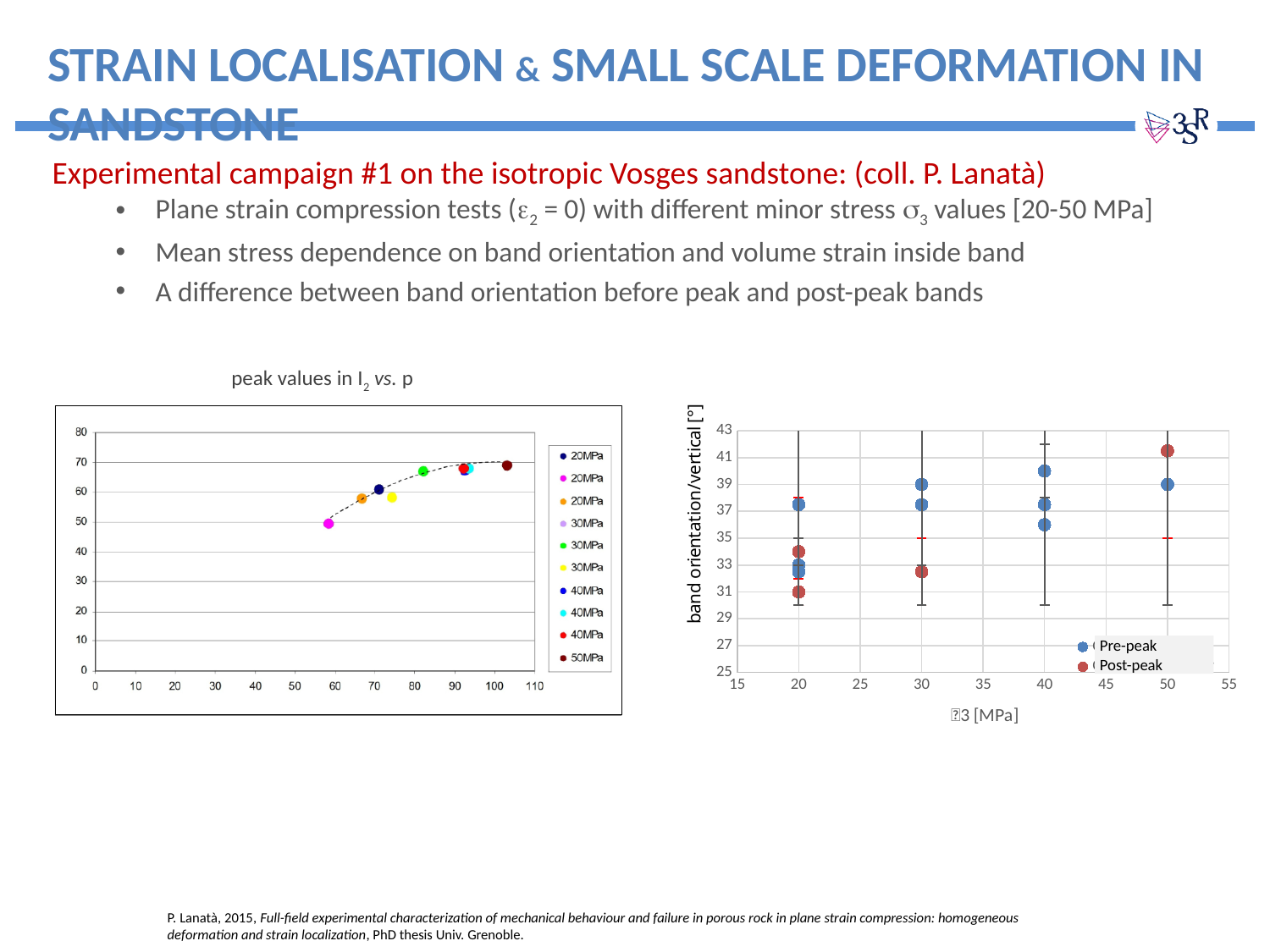
How many entries does the legend of the left-hand chart (peak values in I2 vs. p) list? 10 In the right-hand chart, at σ3 = 50 MPa, which series shows the higher band orientation, Pre-peak or Post-peak? Post-peak In the right-hand chart, is the Post-peak band orientation at σ3 = 50 MPa greater or less than 40°? greater What are the two series named in the legend of the right-hand chart? Pre-peak and Post-peak What is the title of the left-hand chart? peak values in I2 vs. p In the right-hand chart, do the Post-peak band orientation values rise or fall as σ3 increases from 20 to 50 MPa? rise What kind of chart is the right-hand chart of band orientation versus σ3? scatter chart In the right-hand chart, at σ3 = 20 MPa, which series shows the higher band orientation, Pre-peak or Post-peak? Pre-peak In the left-hand chart (peak values in I2 vs. p), is the value for the 50MPa point greater or less than 60? greater How many series does the legend of the right-hand chart (band orientation/vertical) list? 2